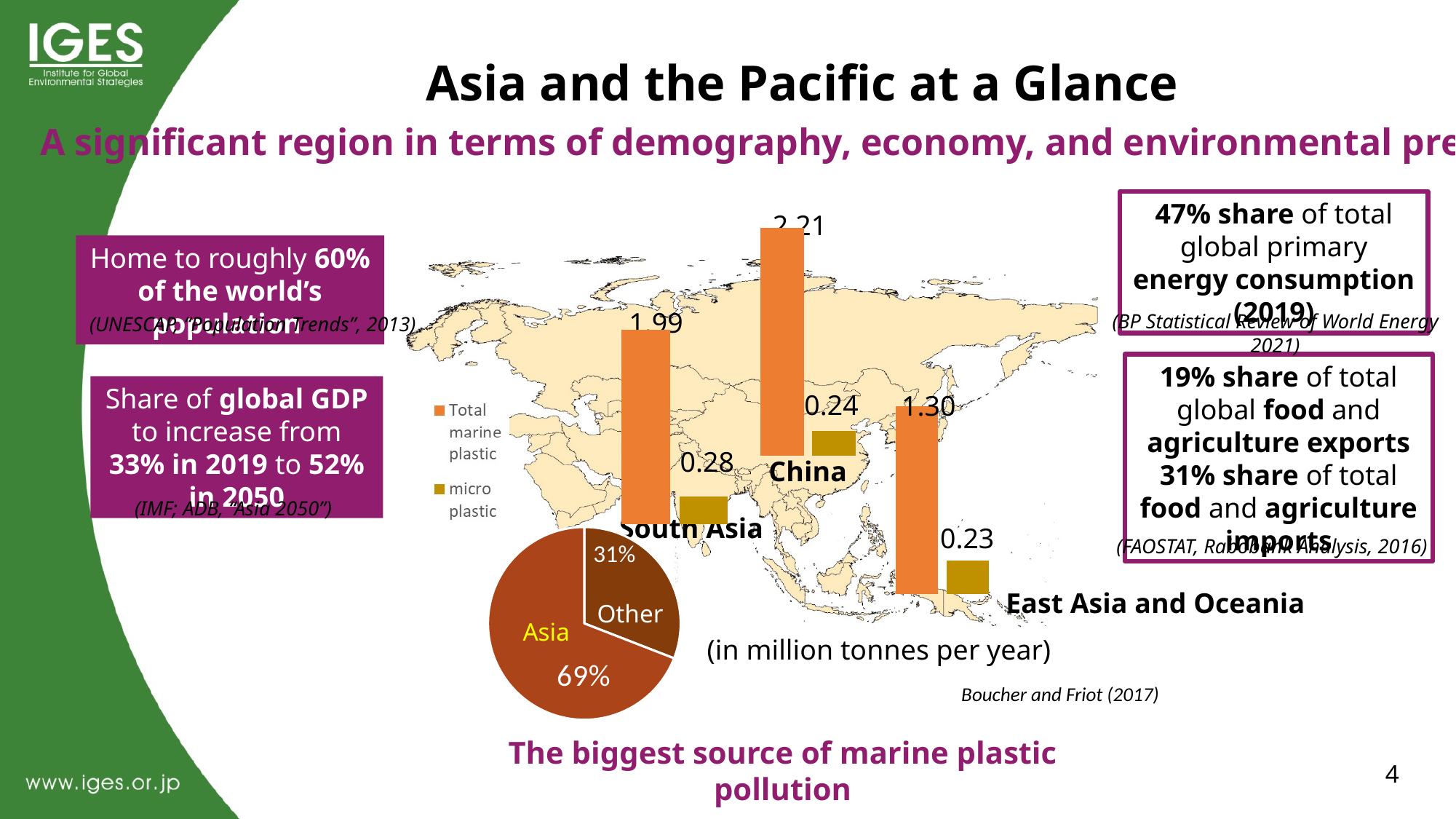
In the bar chart on the map, how many regions are shown? 3 In the bar chart on the map, what is the total marine plastic value for East Asia and Oceania? 1.30 In the bar chart on the map, which region has the highest total marine plastic value? China In the pie chart, what share does Other have? 31% In the bar chart on the map, how many series does the legend list? 2 In the bar chart on the map, what is the total marine plastic value for China? 2.21 What unit is stated for the bar chart values on the map? million tonnes per year In the bar chart on the map, which region has the lowest micro plastic value? East Asia and Oceania In the bar chart on the map, what is the difference between the total marine plastic values for China and South Asia? 0.22 In the pie chart, what share does Asia have? 69% In the bar chart on the map, what is the micro plastic value for South Asia? 0.28 In the bar chart on the map, which is larger: the micro plastic value for China or for South Asia? South Asia